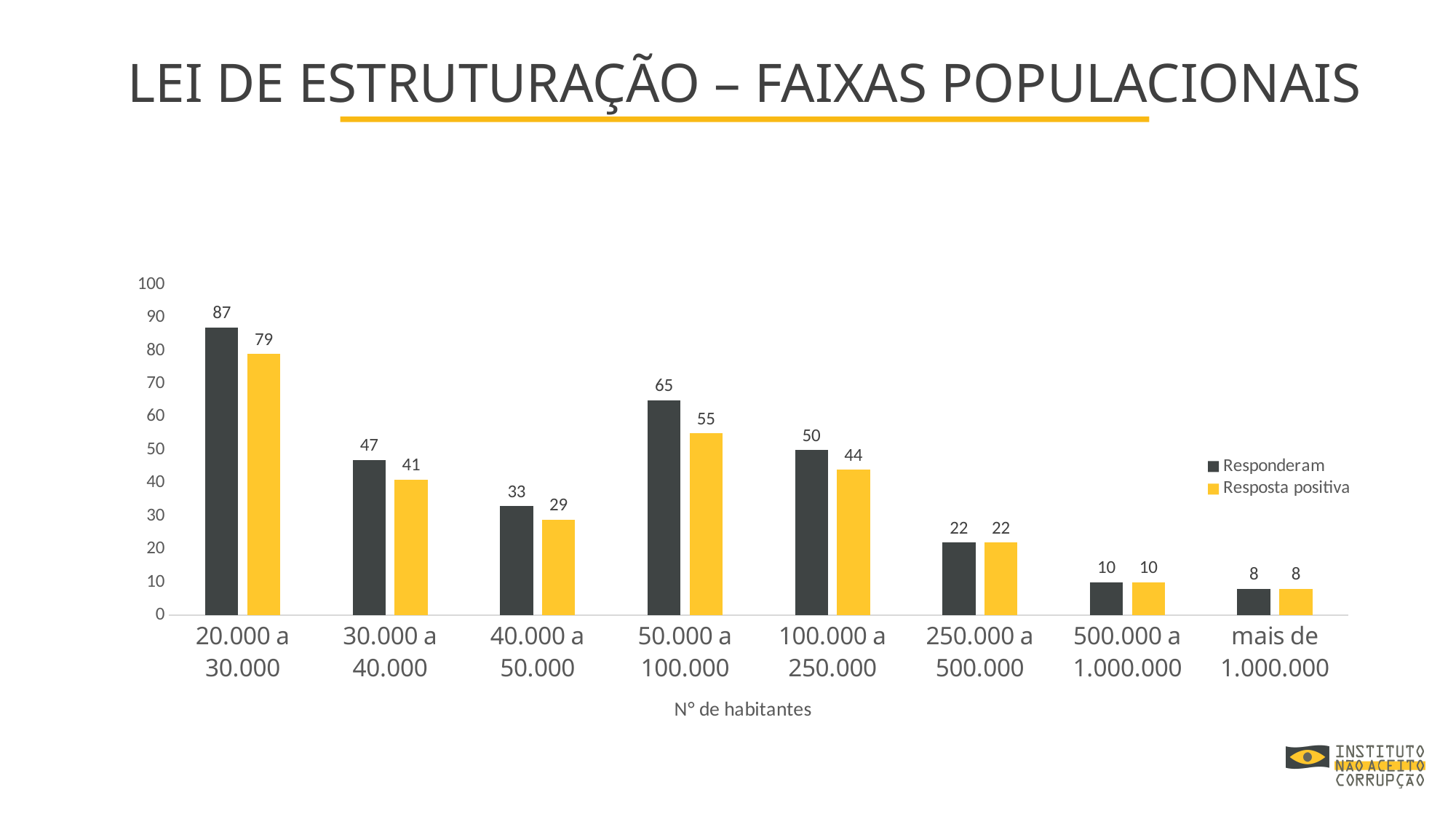
What is the x-axis title of the chart? N° de habitantes How many population categories are shown on the x axis? 8 What is the difference between Responderam and Resposta positiva for the 30.000 a 40.000 category? 6 How many series does the legend list? 2 Which is larger for the 40.000 a 50.000 category: Responderam or Resposta positiva? Responderam What is the value of Resposta positiva for the 50.000 a 100.000 category? 55 Which category has the highest Responderam value? 20.000 a 30.000 What is the value of Responderam for the 20.000 a 30.000 category? 87 What kind of chart is shown on the slide? Bar chart Which category has the lowest Resposta positiva value? mais de 1.000.000 What is the value of Resposta positiva for the 100.000 a 250.000 category? 44 Which colour represents the Resposta positiva series? Yellow